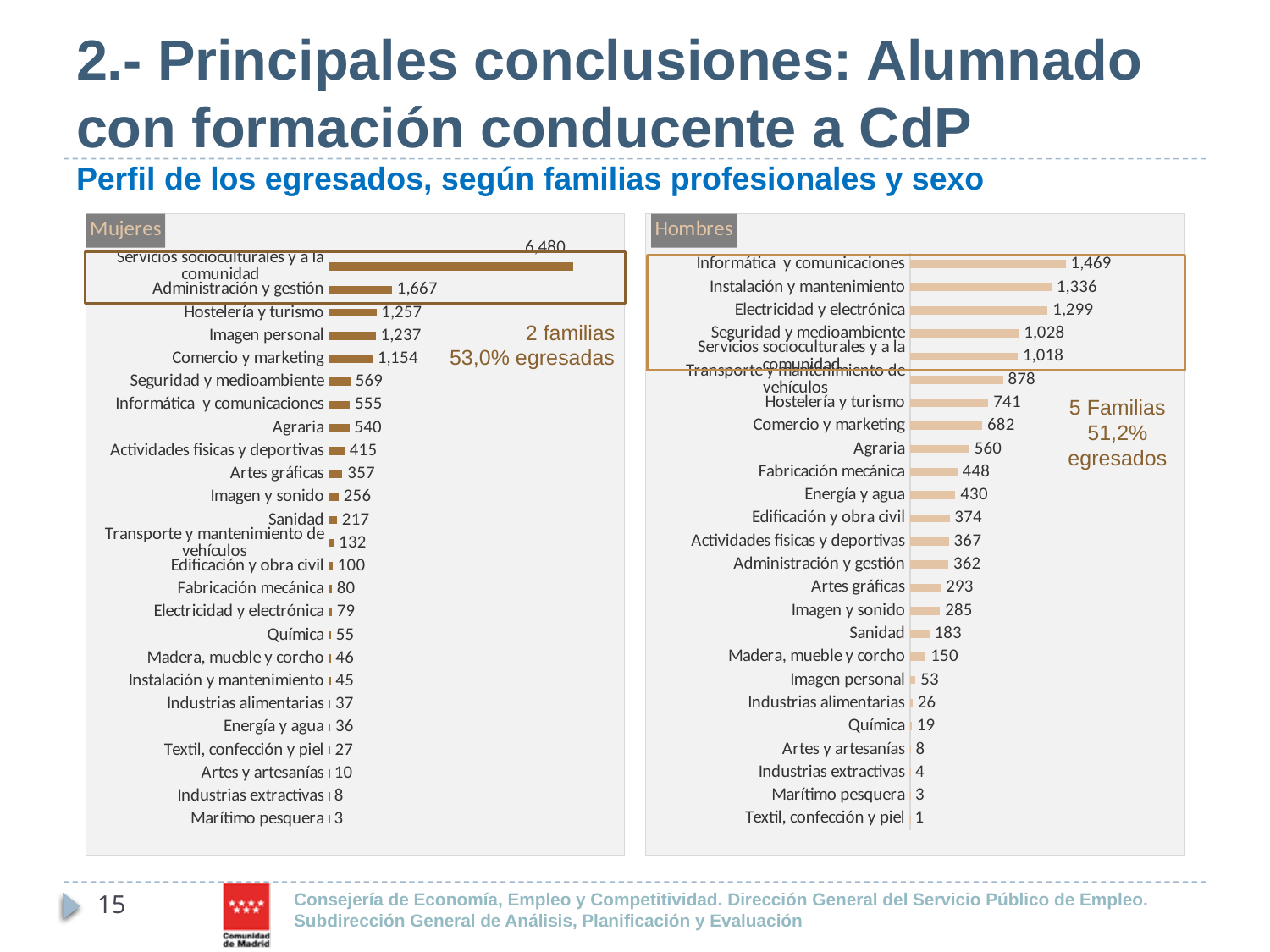
In the Hombres chart, what is the difference between Informática y comunicaciones and Electricidad y electrónica? 170 In the Hombres chart, which is larger: Sanidad or Imagen y sonido? Imagen y sonido In the Hombres chart, what is the value for Instalación y mantenimiento? 1,336 In the Mujeres chart, which category has the highest value? Servicios socioculturales y a la comunidad In the Hombres chart, which category has the lowest value? Textil, confección y piel How many categories are shown in the Hombres chart? 25 What type of chart is the Mujeres chart? Bar chart In the Mujeres chart, what is the value for Marítimo pesquera? 3 In the Mujeres chart, what is the difference between Hostelería y turismo and Imagen personal? 20 In the Mujeres chart, what is the value for Administración y gestión? 1,667 In the Mujeres chart, which is larger: Agraria or Seguridad y medioambiente? Seguridad y medioambiente In the Hombres chart, which category has the highest value? Informática y comunicaciones